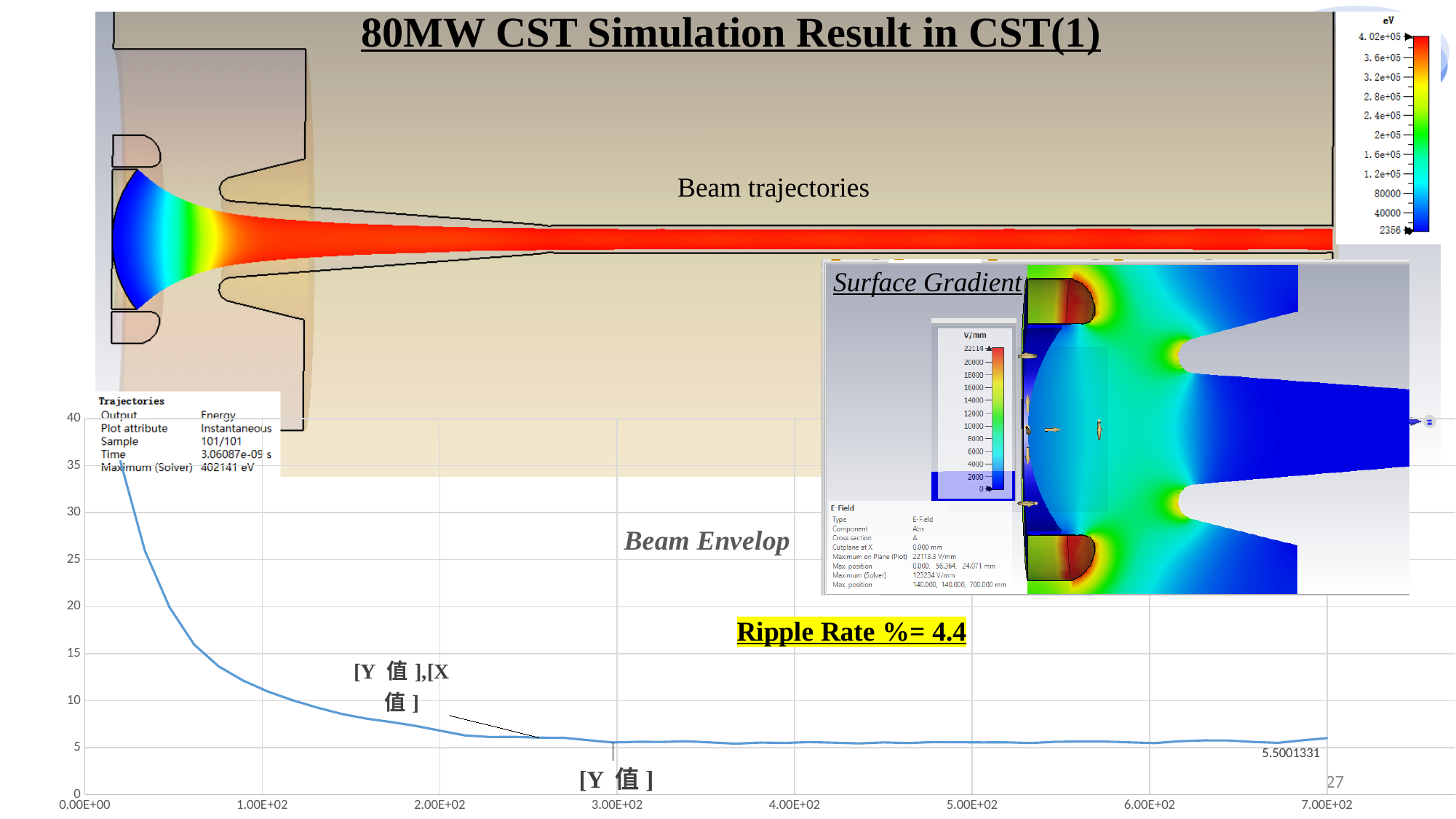
In the Beam Envelop chart, is the value at x = 3.00E+02 greater or less than 10? less In the Beam Envelop chart, what is the largest value labelled on the x axis? 7.00E+02 In the Beam Envelop chart, is the line higher at the left end or the right end of the x axis? left end How many labelled tick marks are there on the x axis of the Beam Envelop chart? 8 In the Beam Envelop chart, what is the highest value labelled on the y axis? 40 What kind of chart is the Beam Envelop plot at the bottom of the slide? line chart In the Beam Envelop chart, is the value at x = 2.00E+02 greater or less than 15? less In the Beam Envelop chart, is the value at x = 5.00E+02 greater or less than 10? less In the Beam Envelop chart, do the values rise or fall as you move along the x axis from left to right? fall In the Beam Envelop chart, what value is printed as the data label near the right end of the line? 5.5001331